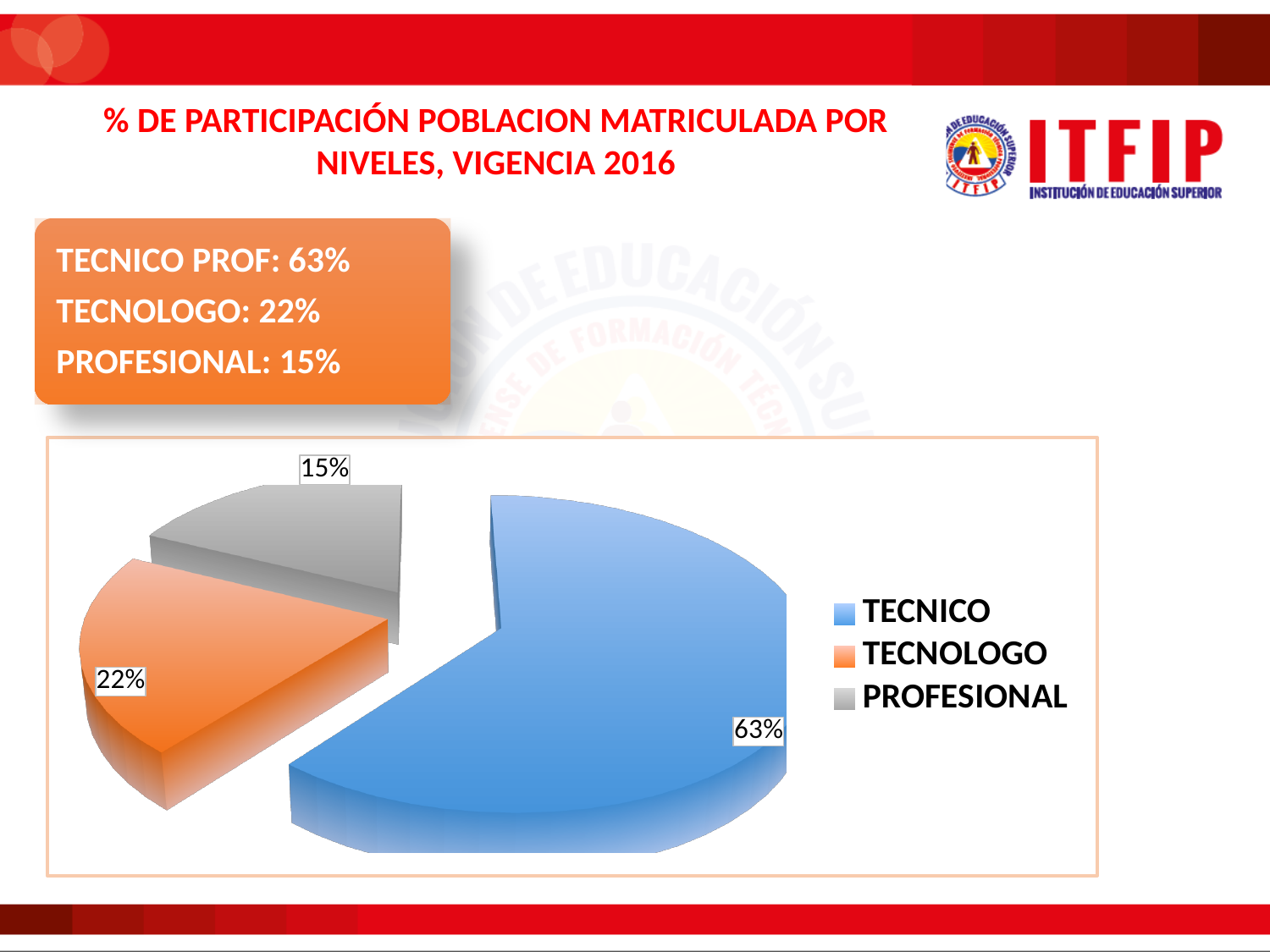
Which is larger, the TECNOLOGO share or the PROFESIONAL share? TECNOLOGO What colour is the TECNOLOGO slice in the pie chart? Orange What kind of chart is shown on the slide? Pie chart What percentage share does the TECNOLOGO slice have? 22% What percentage share does the PROFESIONAL slice have? 15% What is the difference in percentage points between the TECNICO and TECNOLOGO shares? 41 What percentage share does the TECNICO slice have? 63% Which category has the smallest share of the pie? PROFESIONAL How many entries does the legend list? 3 What is the difference in percentage points between the TECNOLOGO and PROFESIONAL shares? 7 Which category has the largest share of the pie? TECNICO How many slices does the pie chart have? 3